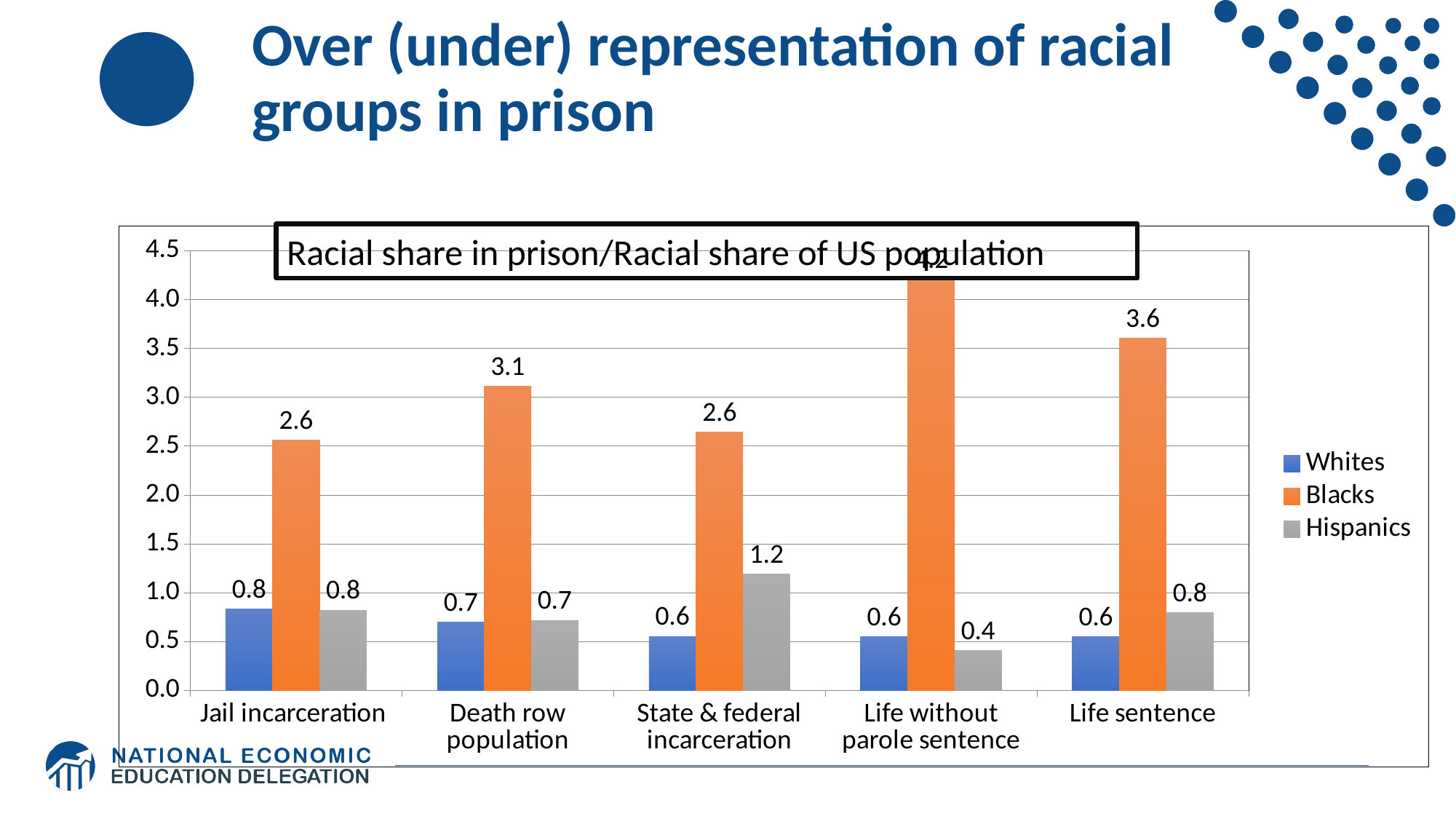
What type of chart is shown on the slide? bar chart How many series does the legend list? 3 In which category is the value for Blacks highest? Life without parole sentence How many categories are shown on the x axis? 5 What is the value for Blacks in the Death row population category? 3.1 What is the difference between the Blacks value and the Whites value in the Life sentence category? 3.0 In which category is the value for Hispanics lowest? Life without parole sentence Which is larger in the State & federal incarceration category, the value for Whites or the value for Hispanics? Hispanics What is the value for Hispanics in the Life without parole sentence category? 0.4 What is the value for Whites in the Jail incarceration category? 0.8 What is the value for Hispanics in the State & federal incarceration category? 1.2 Is the value for Blacks in the Life without parole sentence category greater or less than 4.0? greater